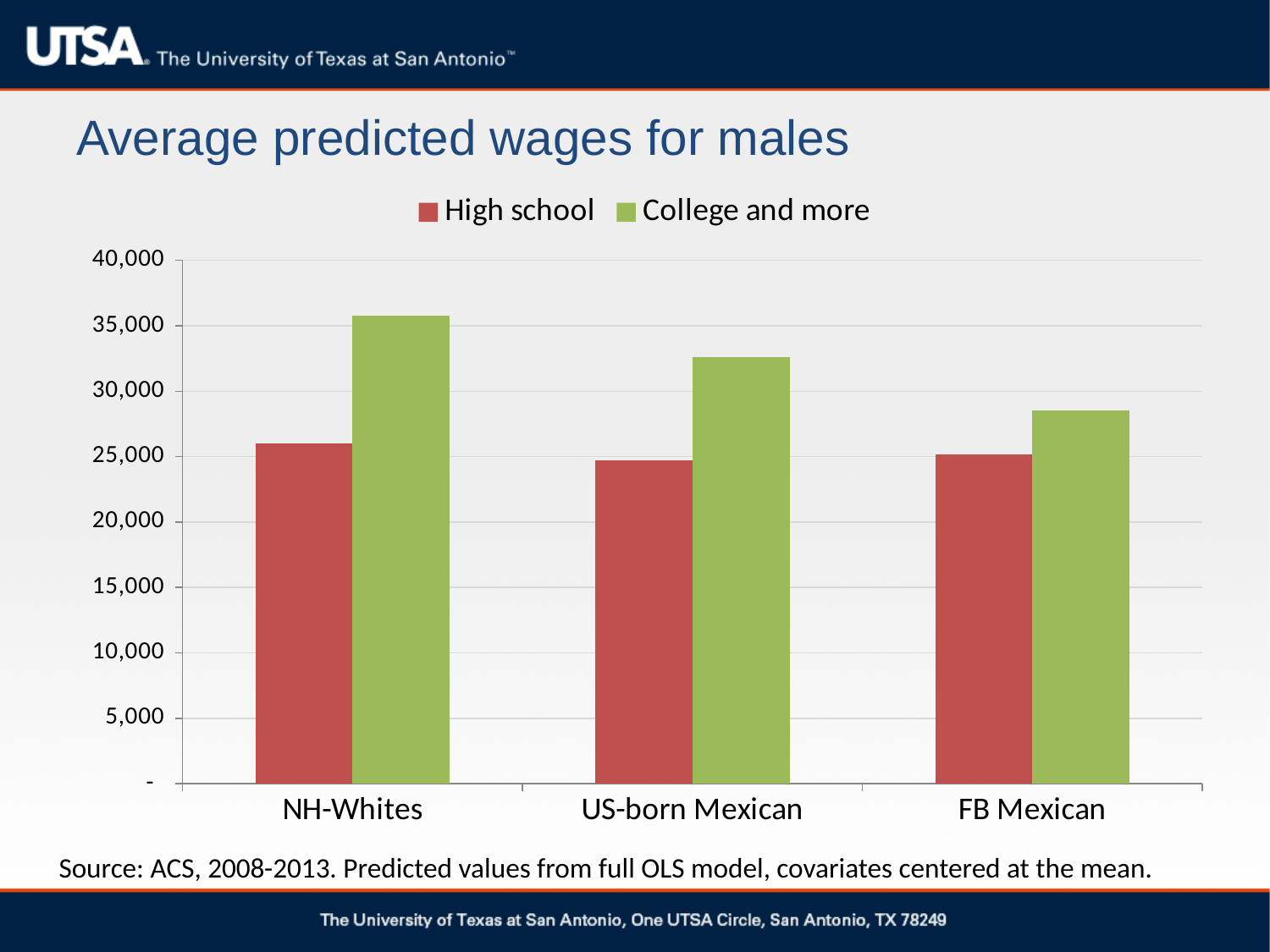
Which category has the highest value for College and more? NH-Whites Is the College and more value for FB Mexican greater or less than 30,000? less Is the College and more value for NH-Whites greater or less than 35,000? greater How many categories are shown on the x axis? 3 What is the title of the chart? Average predicted wages for males How many series does the legend list? 2 Which is larger: the College and more value for NH-Whites or for US-born Mexican? NH-Whites For FB Mexican, which is larger: the High school value or the College and more value? College and more Is the College and more value for US-born Mexican greater or less than 30,000? greater What type of chart is shown on the slide? bar chart Which category has the lowest value for College and more? FB Mexican